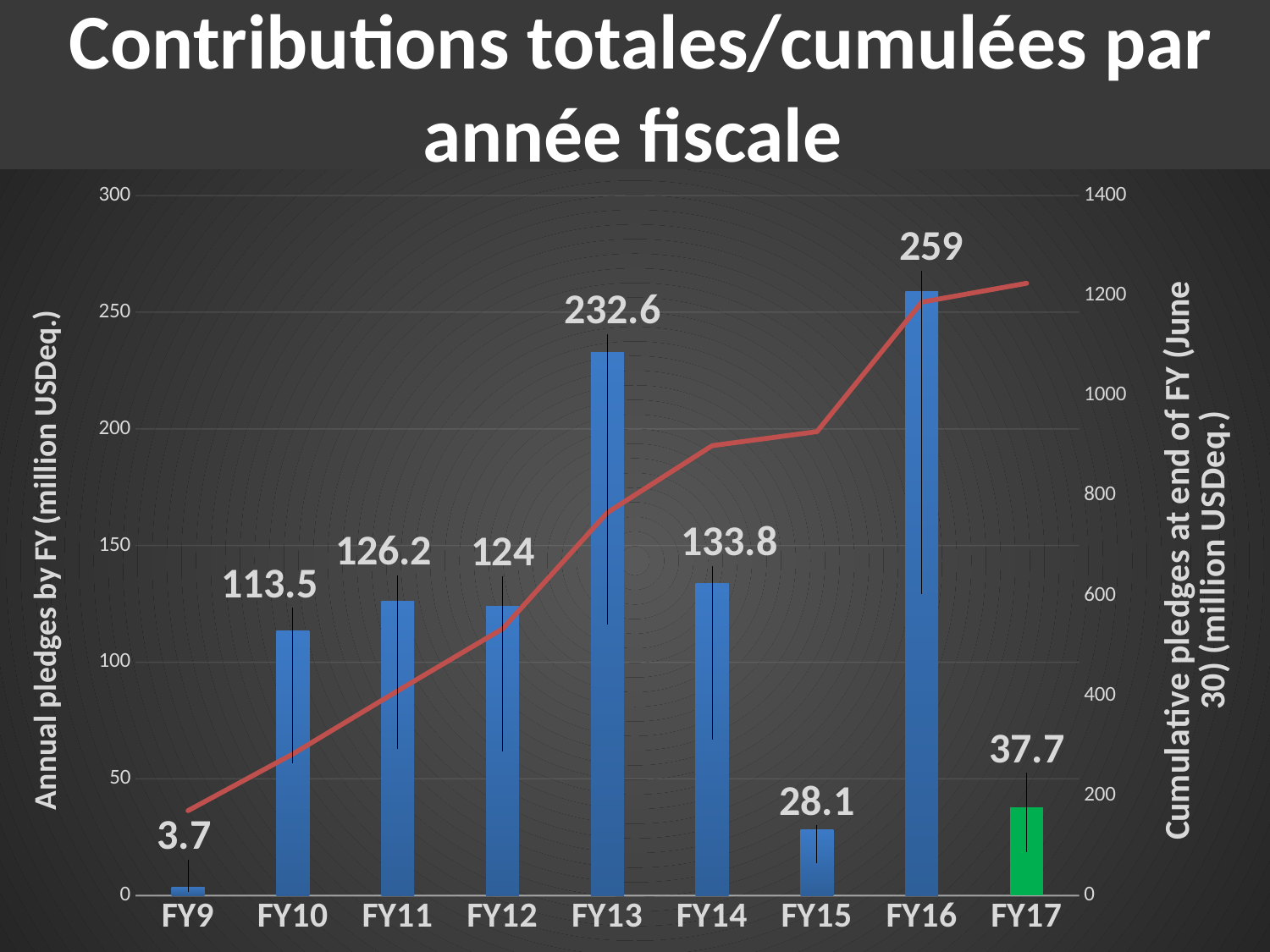
What is the annual pledge value for FY17? 37.7 Which fiscal year has the highest annual pledges? FY16 Does the cumulative pledges line rise or fall from FY9 to FY17? rise Is the cumulative pledges value at the end of FY13 greater or less than 600? greater Is the cumulative pledges value at the end of FY16 greater or less than 1000? greater What is the difference between the annual pledges for FY16 and FY13? 26.4 How many fiscal years are shown on the x axis? 9 Which bar is shown in a different colour (green) from the others? FY17 Which is larger, the annual pledge value for FY11 or for FY12? FY11 What is the annual pledge value for FY13? 232.6 What is the annual pledge value for FY9? 3.7 Which fiscal year has the lowest annual pledges? FY9